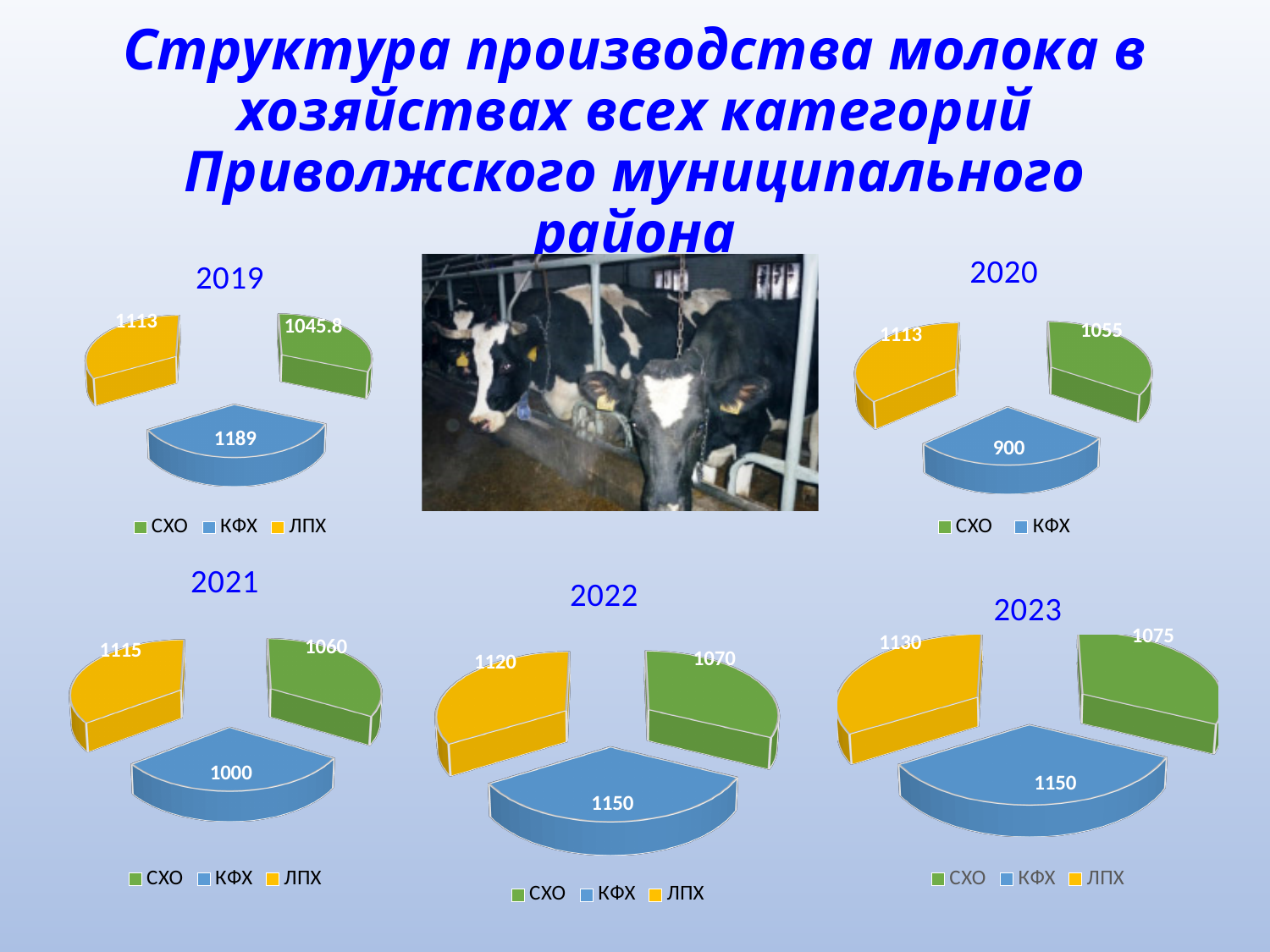
In the 2019 chart, what is the value for КФХ? 1189 In the 2021 chart, what is the value for СХО? 1060 In the 2022 chart, what is the value for ЛПХ? 1120 In the 2023 chart, what is the value for КФХ? 1150 In the 2020 chart, which category has the lowest value? КФХ In the 2021 chart, which is larger, the value for ЛПХ or the value for СХО? ЛПХ In the 2020 chart, what is the value for КФХ? 900 What kind of chart is the 2022 chart? Pie chart In the 2019 chart, which category has the highest value? КФХ In the 2023 chart, which category has the lowest value? СХО In the 2022 chart, what is the difference between the values for КФХ and СХО? 80 How many entries does the legend of the 2020 chart list? 2